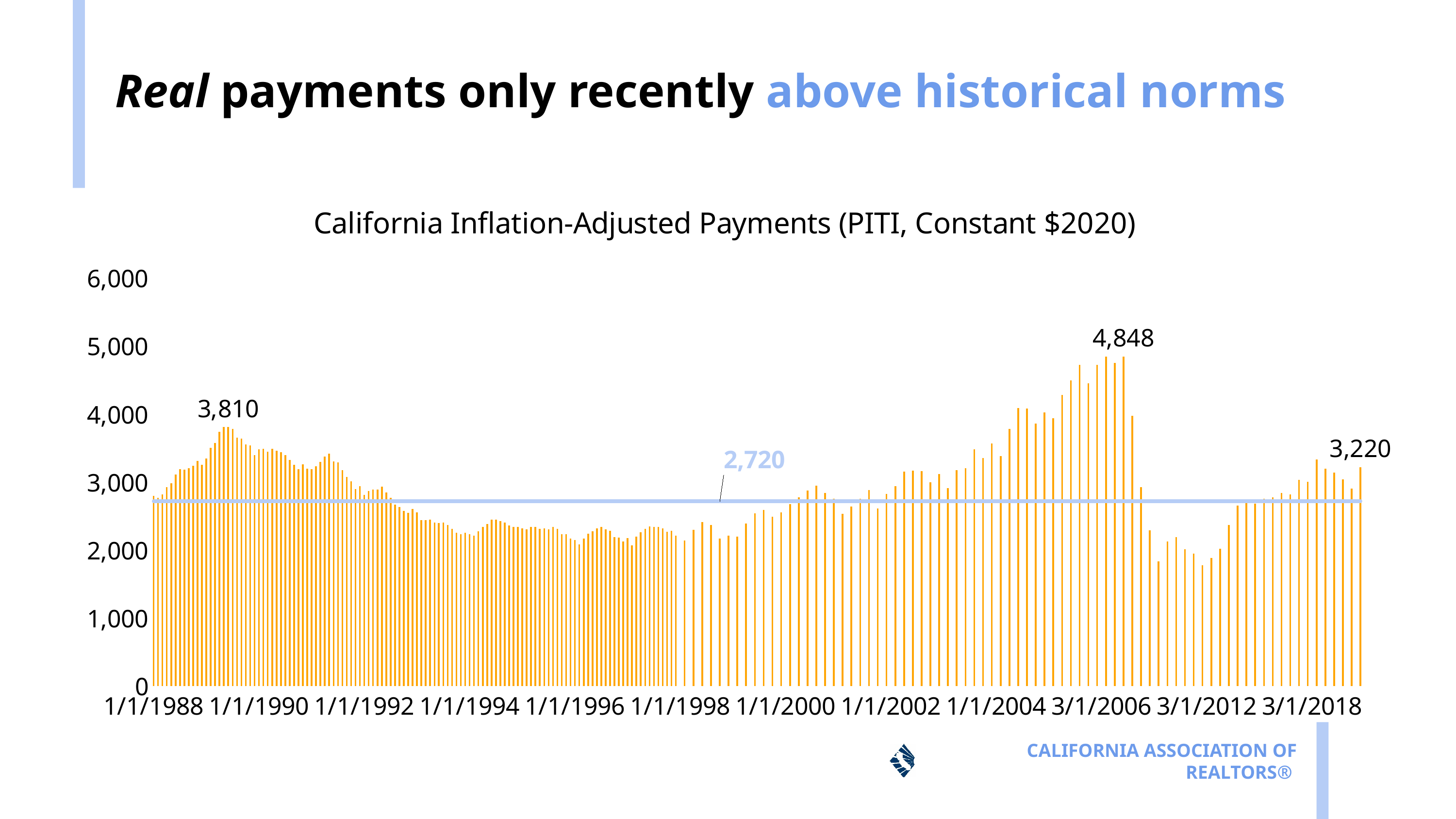
What kind of chart is shown on the slide? bar chart What value is labeled on the horizontal line running across the chart? 2,720 What is the title of the chart? California Inflation-Adjusted Payments (PITI, Constant $2020) What is the highest labeled value on the chart? 4,848 Is the value at the 2006 peak greater or less than 4,000? greater Is the value for 1/1/1996 greater or less than 3,000? less How much higher is the most recent labeled value of 3,220 than the horizontal line value of 2,720? 500 What is the labeled value of the most recent bar at the right end of the chart? 3,220 What is the labeled value of the peak that occurs around 1/1/1990? 3,810 What is the difference between the labeled peak of 4,848 and the earlier labeled peak of 3,810? 1,038 Which is larger: the peak labeled around 2006 or the peak labeled around 1990? the peak around 2006 (4,848) Do the values rise or fall between the 2006 peak and 3/1/2012? fall